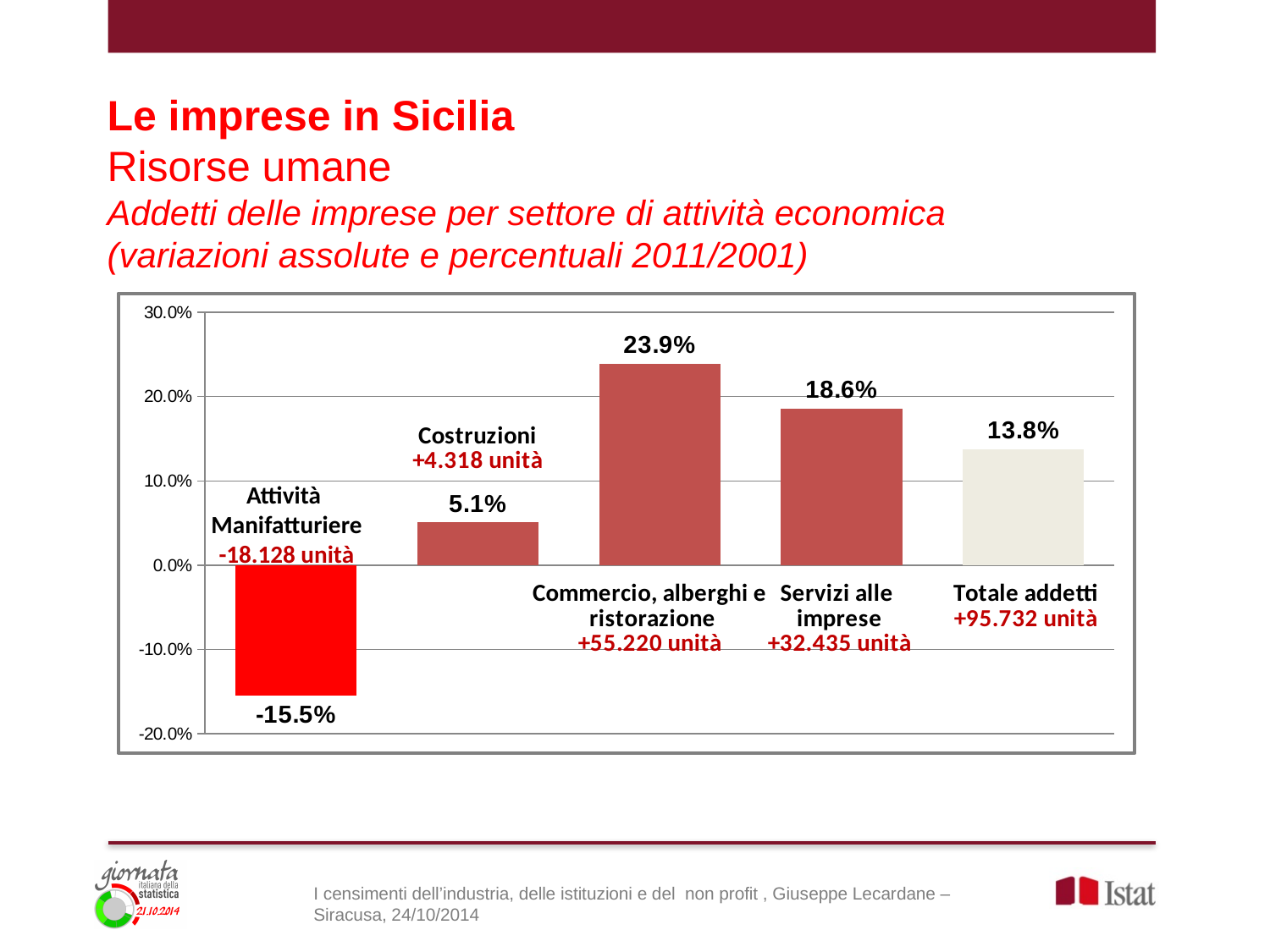
What kind of chart is shown on the slide? Bar chart What is the percentage change shown for Totale addetti? 13.8% How many bars are plotted in the chart? 5 What absolute change in units is shown for Servizi alle imprese? +32.435 unità What is the difference in percentage points between Commercio, alberghi e ristorazione and Servizi alle imprese? 5.3 Which has a larger percentage change, Costruzioni or Servizi alle imprese? Servizi alle imprese Which sector has the highest percentage change? Commercio, alberghi e ristorazione Which sector has the lowest percentage change? Attività Manifatturiere What is the percentage change shown for Costruzioni? 5.1% What is the percentage change shown for Commercio, alberghi e ristorazione? 23.9% What is the percentage change shown for Attività Manifatturiere? -15.5% Which bar is coloured bright red? Attività Manifatturiere